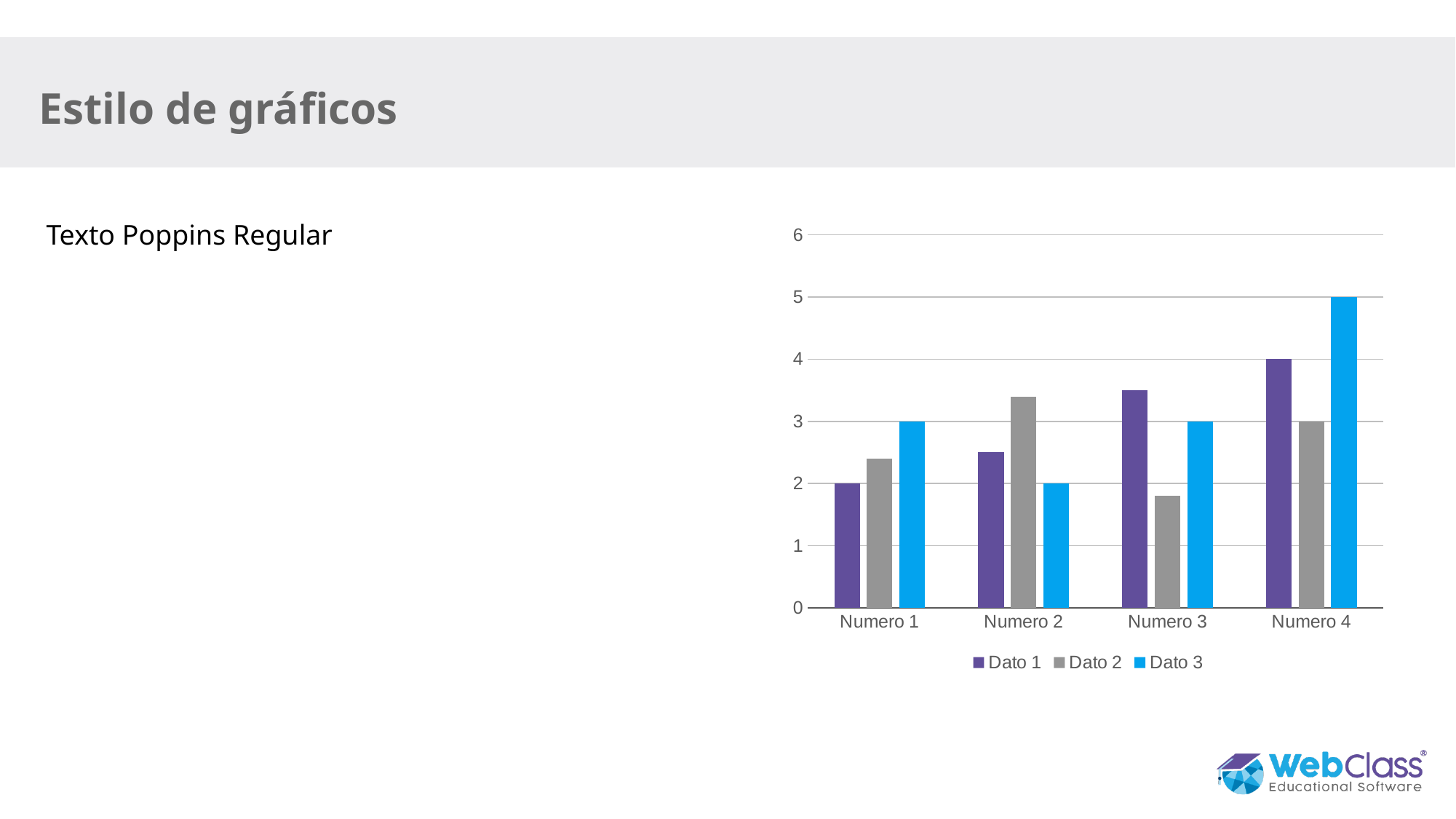
For which category is Dato 3 highest? Numero 4 What is the value of Dato 1 for Numero 4? 4 What is the value of Dato 3 for Numero 4? 5 What is the difference between Dato 3 for Numero 4 and Dato 3 for Numero 1? 2 How many series does the legend list? 3 Which is larger for Numero 2: Dato 1 or Dato 3? Dato 1 For which category is Dato 2 lowest? Numero 3 What is the value of Dato 1 for Numero 1? 2 What is the value of Dato 3 for Numero 1? 3 What type of chart is shown on the slide? bar chart How many categories are shown on the x axis? 4 Is the value of Dato 2 for Numero 2 greater or less than 3? greater